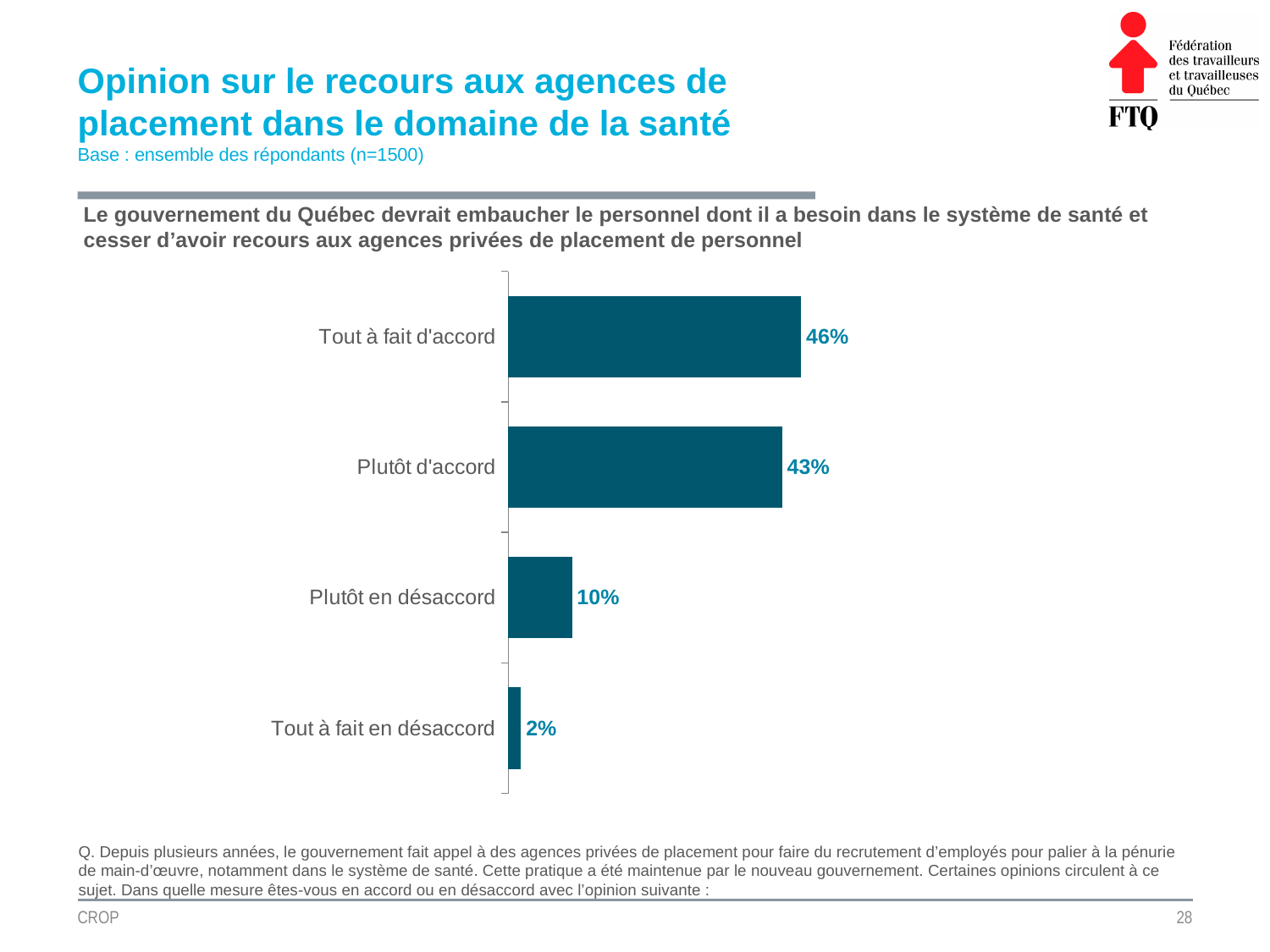
What percentage of respondents answered "Tout à fait d'accord"? 46% What is the combined value of "Tout à fait d'accord" and "Plutôt d'accord"? 89% What kind of chart is shown on the slide? Bar chart What is the value shown for "Tout à fait en désaccord"? 2% Which response category has the lowest value? Tout à fait en désaccord What percentage of respondents answered "Plutôt en désaccord"? 10% Which is larger: the value for "Plutôt d'accord" or the value for "Plutôt en désaccord"? Plutôt d'accord What is the value shown for "Plutôt d'accord"? 43% What is the difference between "Plutôt en désaccord" and "Tout à fait en désaccord"? 8% What is the difference between "Tout à fait d'accord" and "Plutôt d'accord"? 3% Which response category has the highest value? Tout à fait d'accord How many response categories are shown in the chart? 4